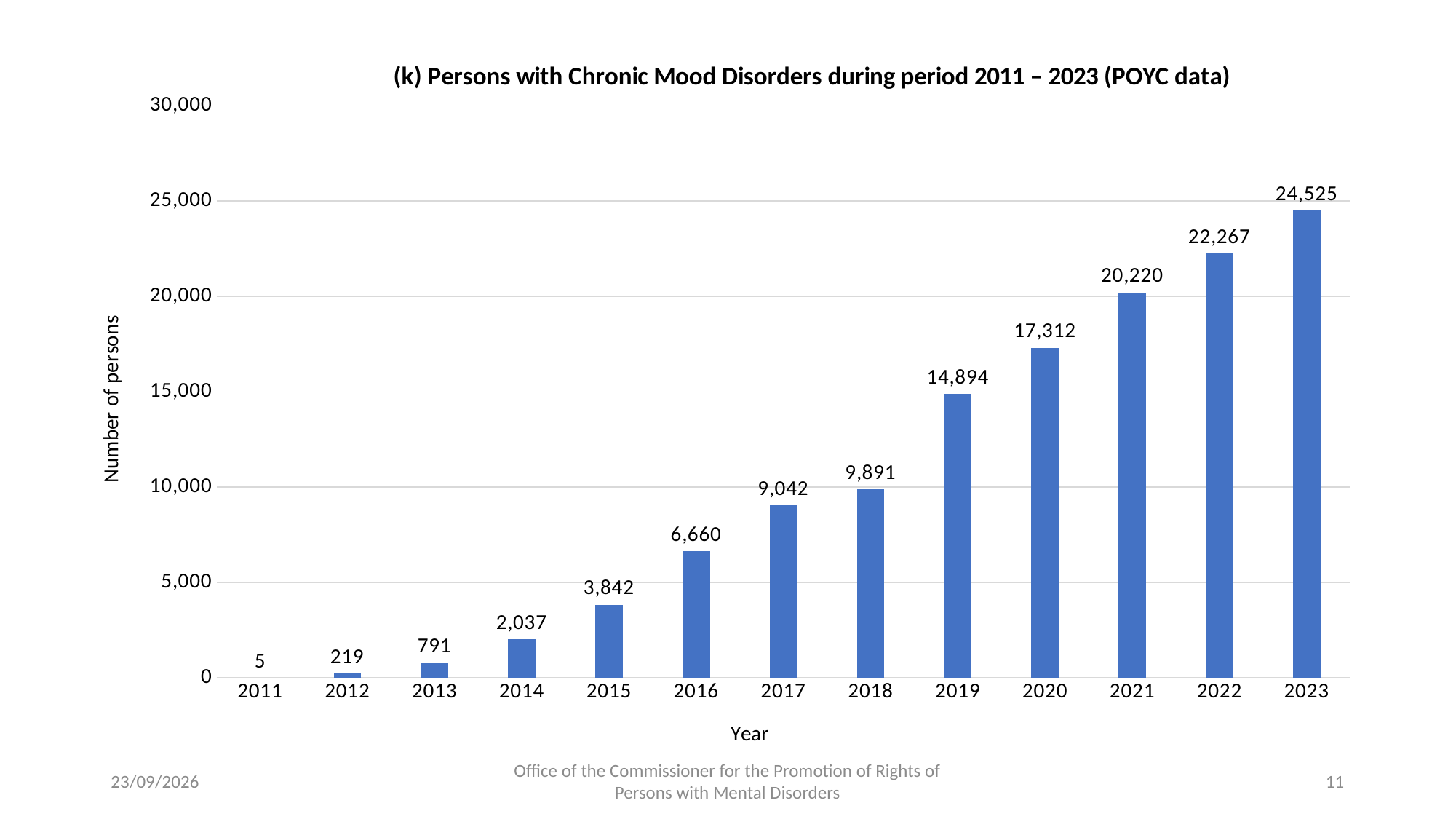
What is the label of the y axis? Number of persons Do the values rise or fall from 2011 to 2023? Rise What is the number of persons with chronic mood disorders in 2019? 14,894 Which year has the highest number of persons with chronic mood disorders? 2023 Which year has the lowest number of persons with chronic mood disorders? 2011 What is the number of persons with chronic mood disorders in 2014? 2,037 What kind of chart is shown on the slide? Bar chart How many years are shown on the x axis of the chart? 13 Is the value for 2020 greater or less than 15,000? greater What is the title of the chart? (k) Persons with Chronic Mood Disorders during period 2011 – 2023 (POYC data) Which year has a larger value, 2017 or 2018? 2018 What is the difference between the values for 2023 and 2022? 2,258